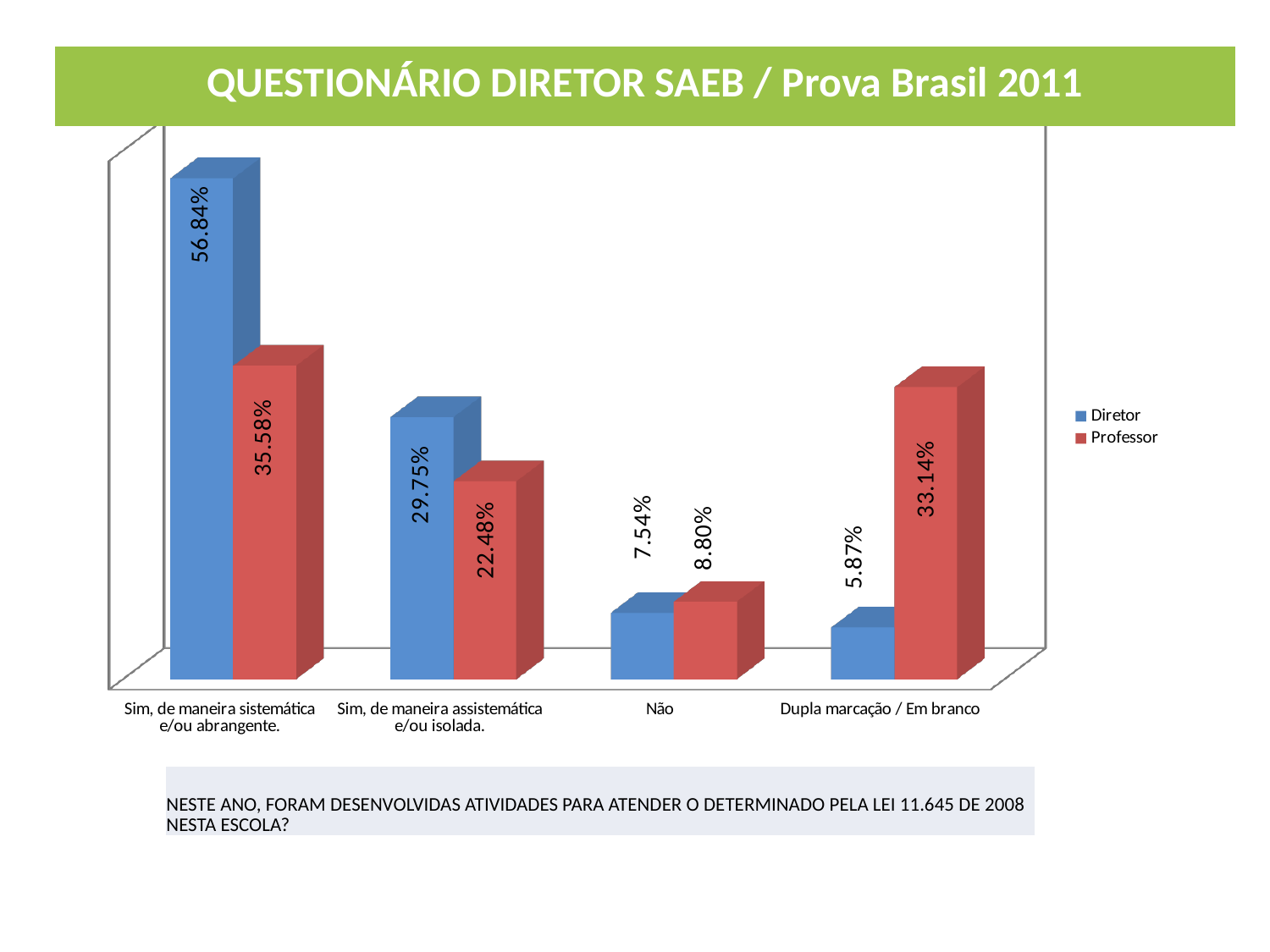
What is the Professor value for "Não"? 8.80% How many categories are shown on the x axis? 4 What is the Professor value for "Dupla marcação / Em branco"? 33.14% For "Dupla marcação / Em branco", which series has the larger value, Diretor or Professor? Professor What is the Diretor value for "Sim, de maneira assistemática e/ou isolada."? 29.75% How many series does the legend list? 2 What is the Diretor value for "Sim, de maneira sistemática e/ou abrangente."? 56.84% What is the difference between the Diretor and Professor values for "Sim, de maneira sistemática e/ou abrangente."? 21.26% What kind of chart is shown on the slide? Bar chart Which category has the highest Diretor value? Sim, de maneira sistemática e/ou abrangente. What is the Professor value for "Sim, de maneira sistemática e/ou abrangente."? 35.58% Which category has the lowest Diretor value? Dupla marcação / Em branco